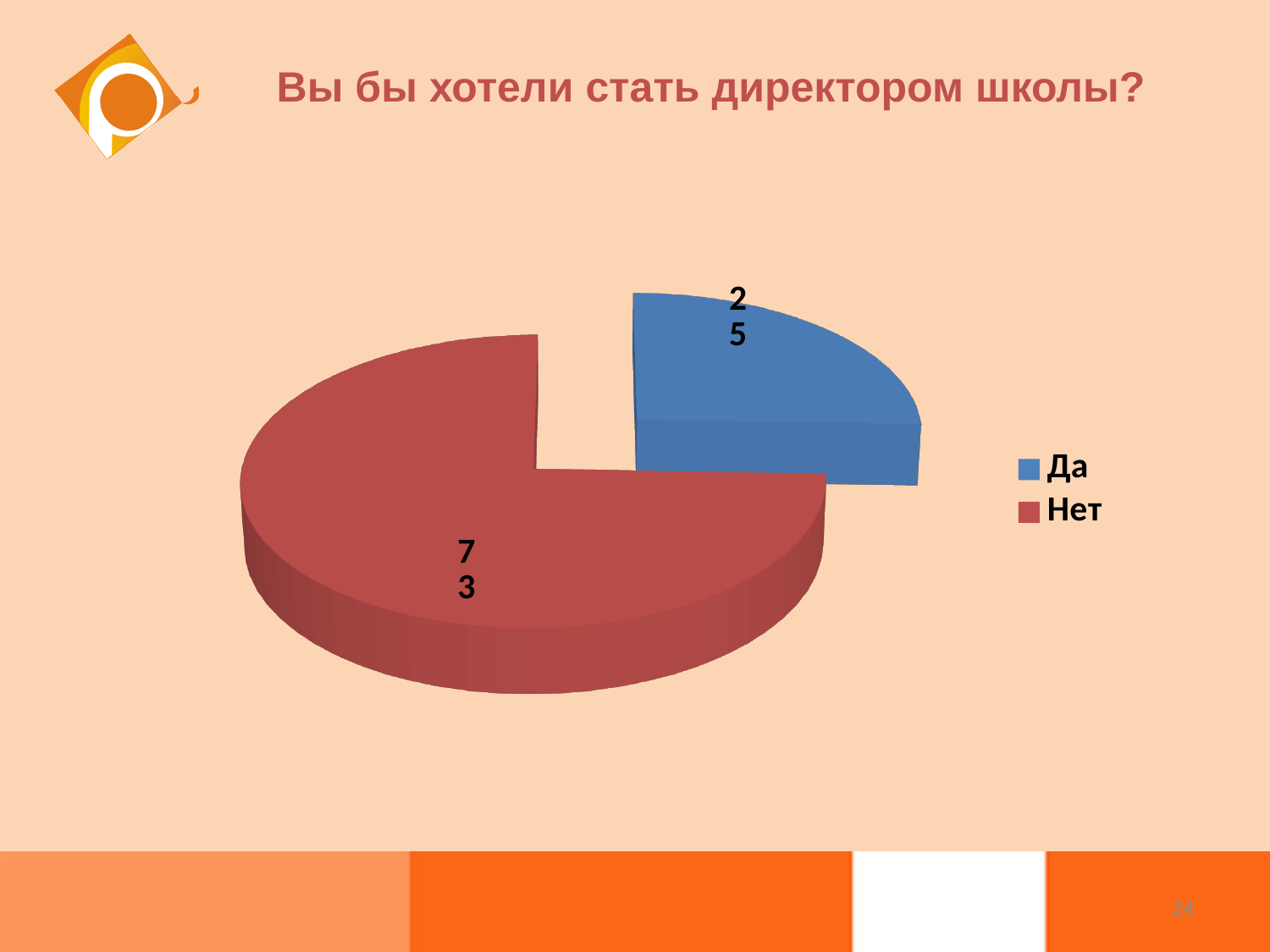
What kind of chart is shown on the slide? Pie chart What is the difference between the Нет value and the Да value? 48 How many slices does the pie chart have? 2 What colour is the Да slice? Blue Which slice is the largest? Нет What is the value shown for the Да slice? 25 Which slice is the smallest? Да What is the title of the slide? Вы бы хотели стать директором школы? What is the value shown for the Нет slice? 73 Which is larger, the value for Да or the value for Нет? Нет What is the sum of the two values shown on the pie chart? 98 How many entries does the legend list? 2